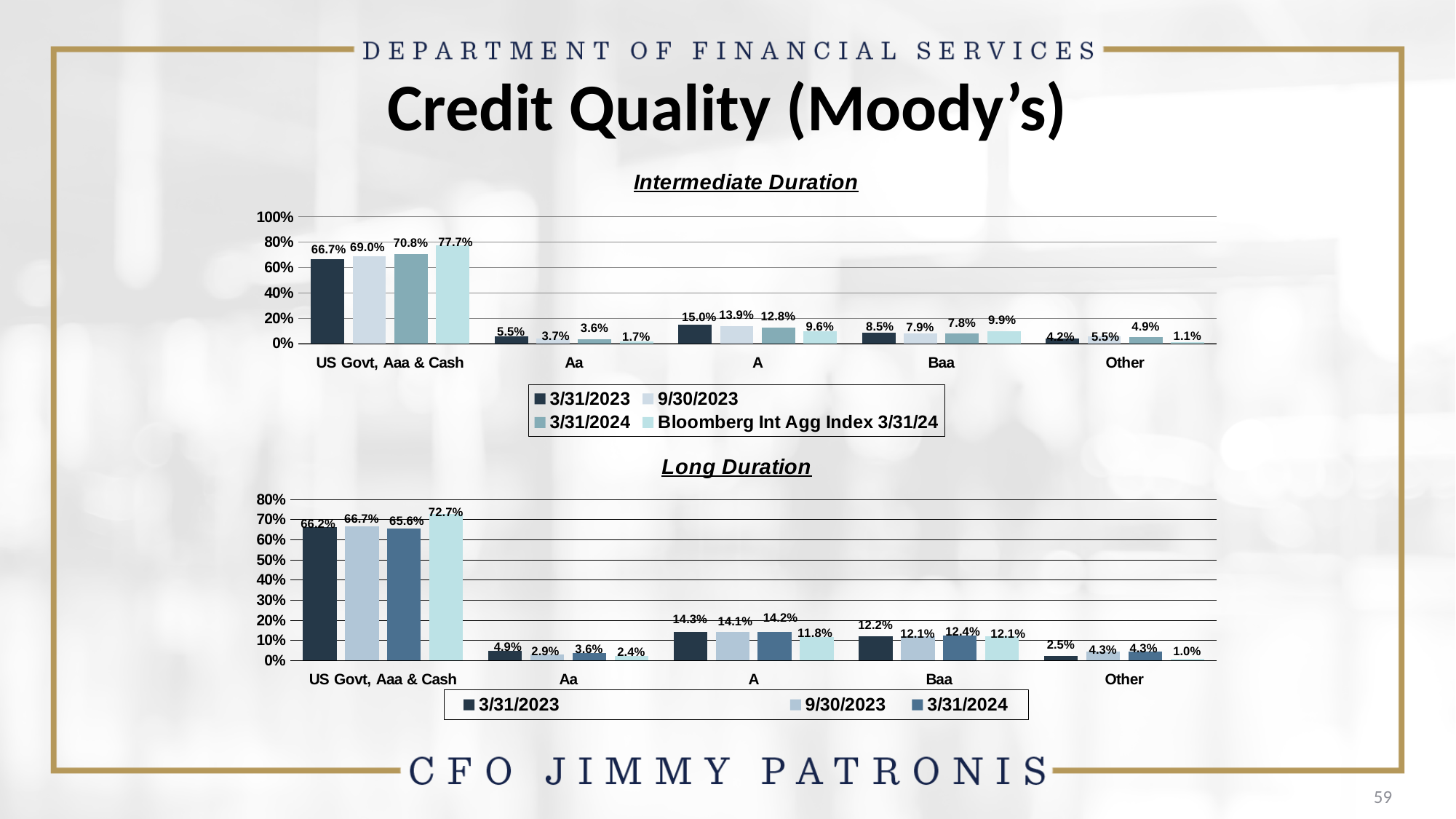
In the Intermediate Duration chart, which category has the highest value for the 3/31/2024 series? US Govt, Aaa & Cash In the Intermediate Duration chart, what is the value for A for the 3/31/2023 series? 15.0% In the Intermediate Duration chart, what is the value for US Govt, Aaa & Cash for the 3/31/2024 series? 70.8% In the Long Duration chart, what is the value for Baa for the 3/31/2024 series? 12.4% In the Intermediate Duration chart, what is the difference between the 3/31/2023 and 3/31/2024 values for A? 2.2% What type of chart is the Long Duration chart? Bar chart How many series does the legend of the Intermediate Duration chart list? 4 In the Long Duration chart, which category has the lowest value for the 9/30/2023 series? Aa How many categories are shown on the x axis of the Long Duration chart? 5 In the Long Duration chart, which is larger for Aa: the 3/31/2023 value or the 3/31/2024 value? 3/31/2023 In the Intermediate Duration chart, what is the Bloomberg Int Agg Index 3/31/24 value for Baa? 9.9% In the Long Duration chart, what is the value for Other for the 3/31/2023 series? 2.5%